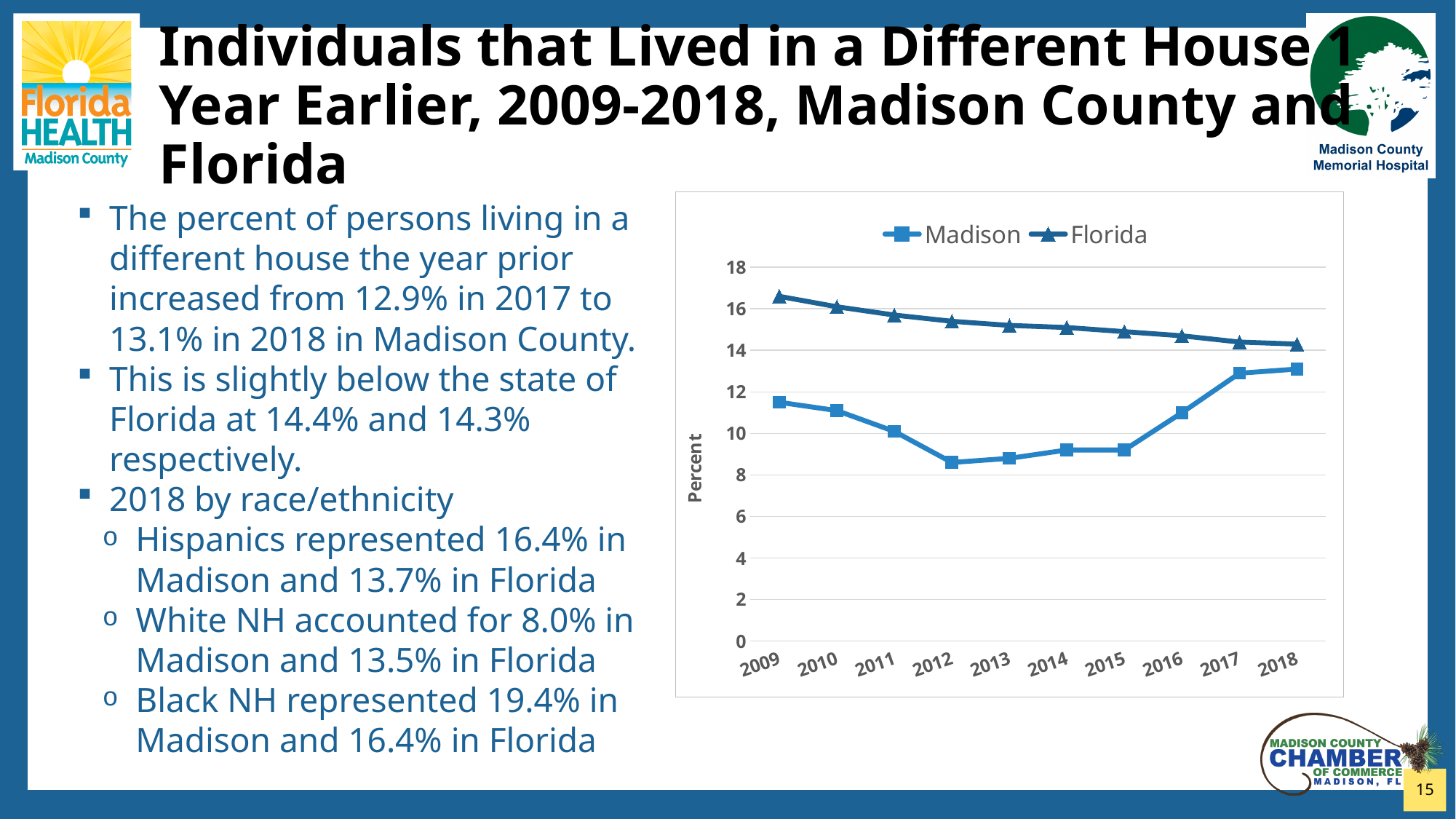
Which series is plotted with triangle markers in the chart? Florida What kind of chart is shown on the slide? line chart For Madison, which is larger, the value in 2009 or the value in 2012? 2009 What is the label on the chart's vertical axis? Percent How many series does the chart's legend list? 2 How many years are plotted along the x axis of the chart? 10 In 2009, which is larger, the Madison value or the Florida value? Florida In which year is the Florida value highest? 2009 Does the Florida line rise or fall from 2009 to 2018? fall Is the Madison value for 2012 greater or less than 10? less Is the Florida value for 2009 greater or less than 16? greater Is the Madison value for 2016 greater or less than 10? greater